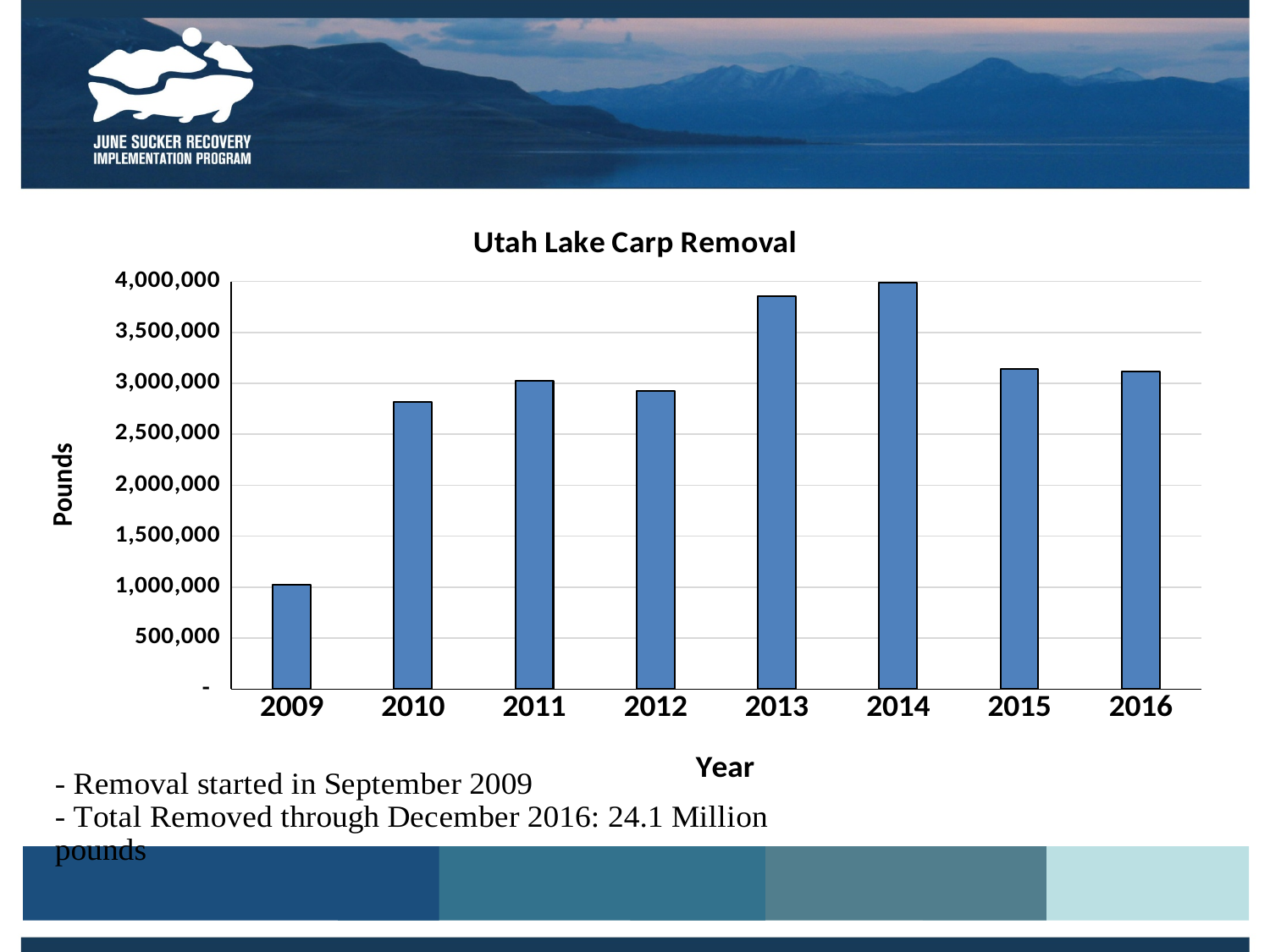
Is the value for 2009 greater or less than 1,500,000? less Is the value for 2015 greater or less than 3,000,000? greater How many years are shown on the x axis of the chart? 8 Do the values rise or fall from 2014 to 2016? fall Is the value for 2013 greater or less than 3,500,000? greater Which year has the highest carp removal? 2014 What is the label on the vertical axis of the chart? Pounds What kind of chart is shown on the slide? Bar chart Which year has the lowest carp removal? 2009 What is the title of the chart? Utah Lake Carp Removal Which year has the larger carp removal, 2013 or 2015? 2013